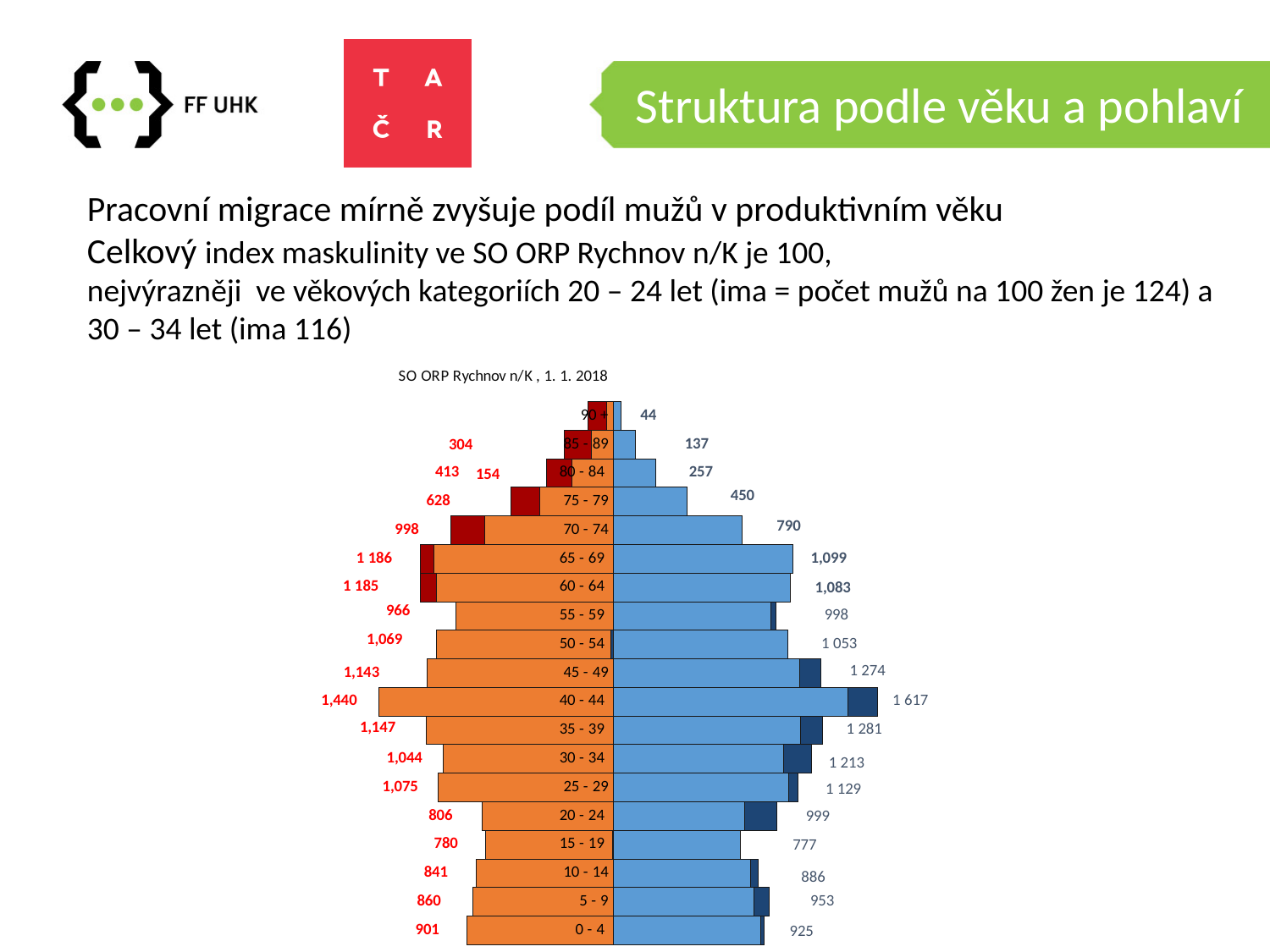
What kind of chart is shown on the slide? bar chart (population pyramid) What is the value shown on the left (orange) side for the 20 - 24 age group? 806 Which age group has the highest value on the right (blue) side of the pyramid? 40 - 44 What is the value shown on the right (blue) side for the 90 + age group? 44 What is the title of the chart? SO ORP Rychnov n/K , 1. 1. 2018 How many age groups are shown in the pyramid? 19 What is the difference between the right-side value (999) and the left-side value (806) for the 20 - 24 age group? 193 What is the value shown on the left (orange) side of the pyramid for the 40 - 44 age group? 1,440 For the 45 - 49 age group, which side has the larger value, the left (orange) or the right (blue)? right (blue) What is the value shown on the right (blue) side for the 0 - 4 age group? 925 Which age group has the lowest value on the right (blue) side of the pyramid? 90 + What is the value shown on the right (blue) side of the pyramid for the 40 - 44 age group? 1 617